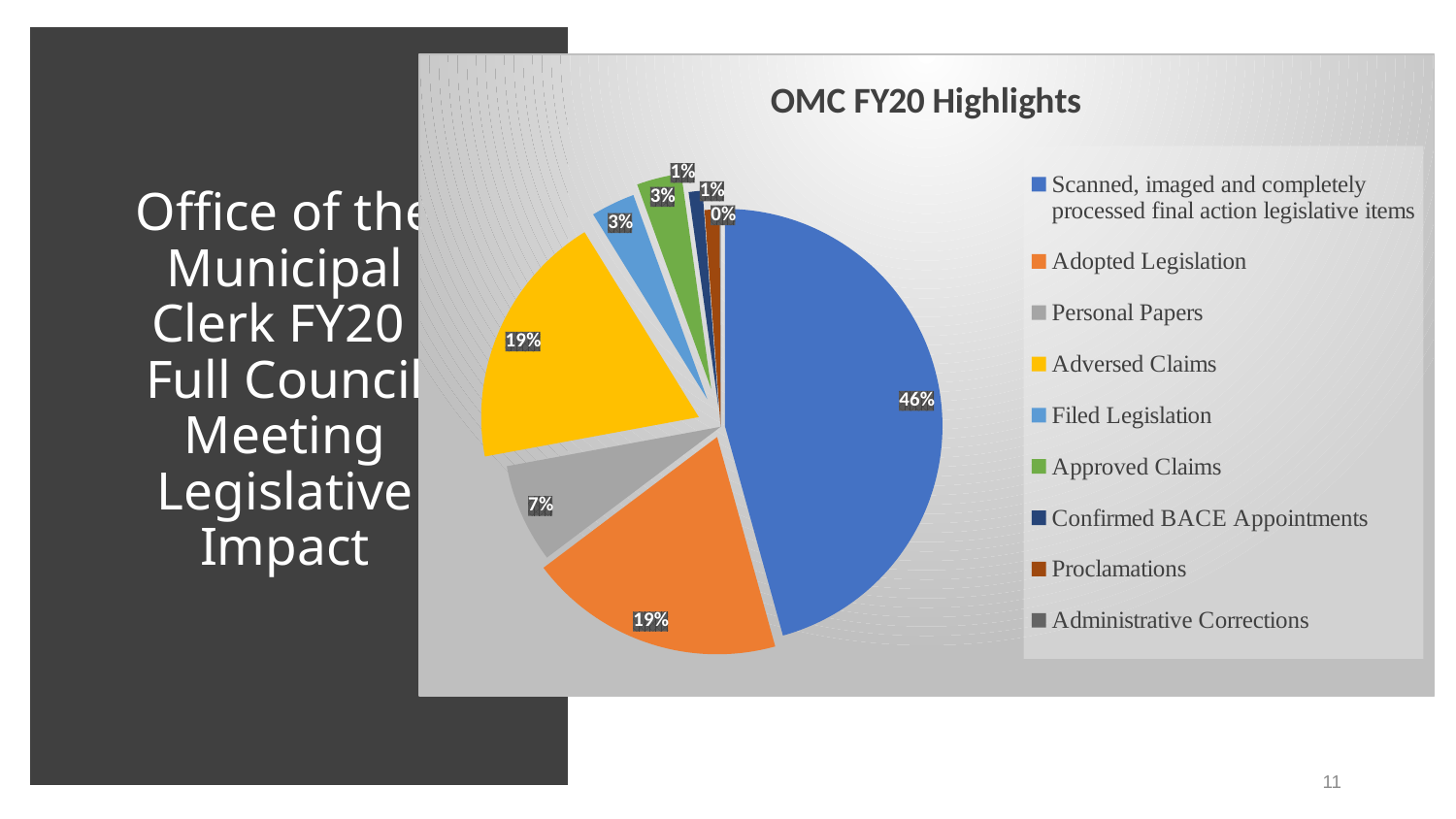
Which category has the largest share of the pie? Scanned, imaged and completely processed final action legislative items What percentage of the pie is 'Personal Papers'? 7% What percentage of the pie is 'Scanned, imaged and completely processed final action legislative items'? 46% What colour is the slice for 'Adversed Claims'? yellow What is the difference in percentage points between 'Scanned, imaged and completely processed final action legislative items' and 'Adversed Claims'? 27 Which category has the smallest share of the pie? Administrative Corrections What is the title of the chart? OMC FY20 Highlights What percentage of the pie is 'Adopted Legislation'? 19% What percentage of the pie is 'Filed Legislation'? 3% What type of chart is shown on the slide? pie chart Which is larger, the share for 'Personal Papers' or the share for 'Approved Claims'? Personal Papers How many categories does the legend list? 9